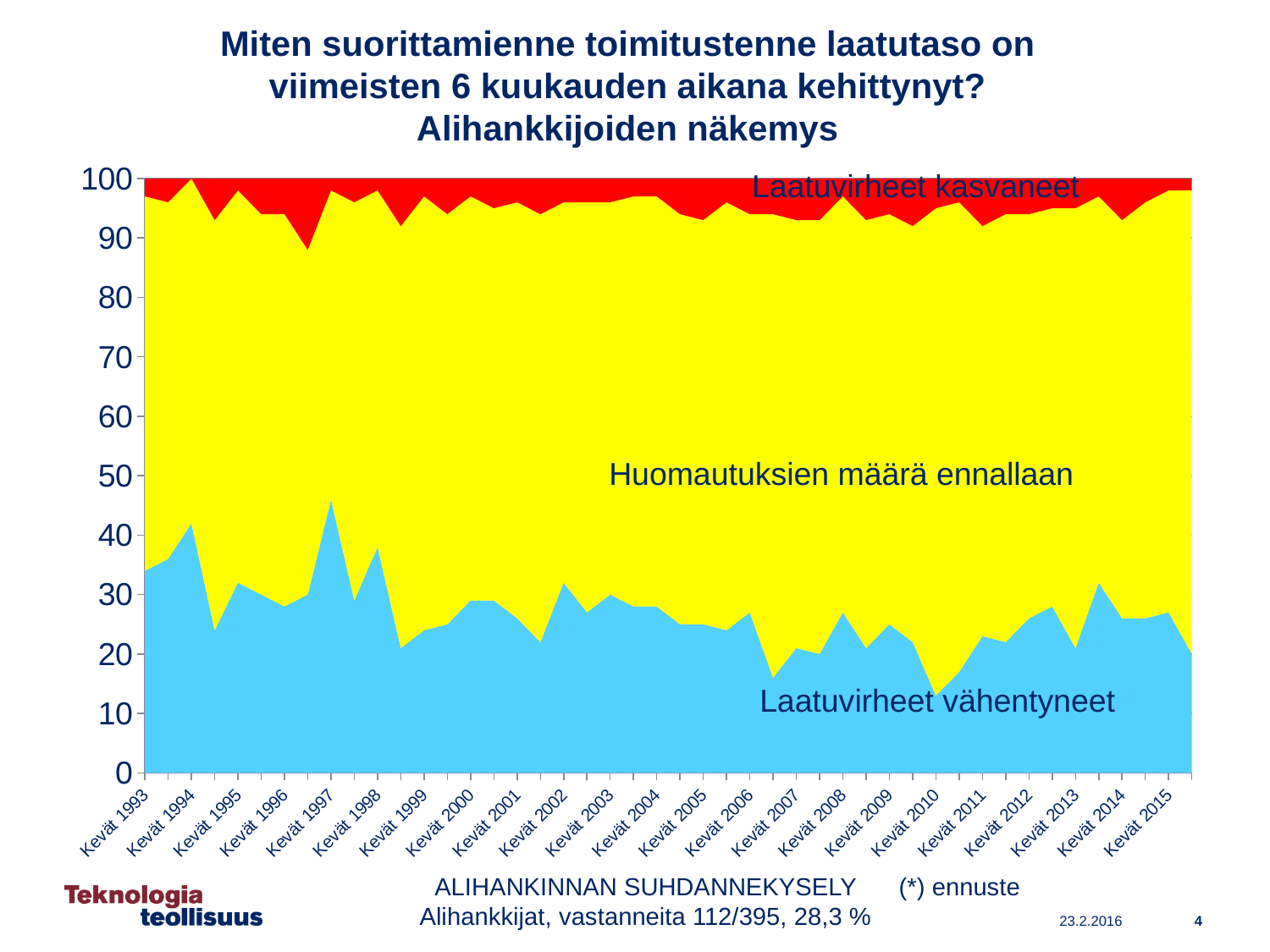
Is the value for Laatuvirheet vähentyneet at Kevät 1993 greater or less than 30? greater Which series is shown in red at the top of the chart? Laatuvirheet kasvaneet Does the Laatuvirheet vähentyneet series overall rise or fall from Kevät 1993 to Kevät 2015? Fall Which series is shown in blue at the bottom of the chart? Laatuvirheet vähentyneet What kind of chart is shown on the slide? Stacked area chart How many labelled years (Kevät 1993 to Kevät 2015) appear on the x axis? 23 Is the value for Laatuvirheet vähentyneet at Kevät 1997 greater or less than 40? greater At which labelled year does the Laatuvirheet vähentyneet series reach its lowest value? Kevät 2010 How many series are labelled in the chart? 3 Is the value for Laatuvirheet vähentyneet at Kevät 2014 greater or less than 30? less At which labelled year does the Laatuvirheet vähentyneet series reach its highest value? Kevät 1997